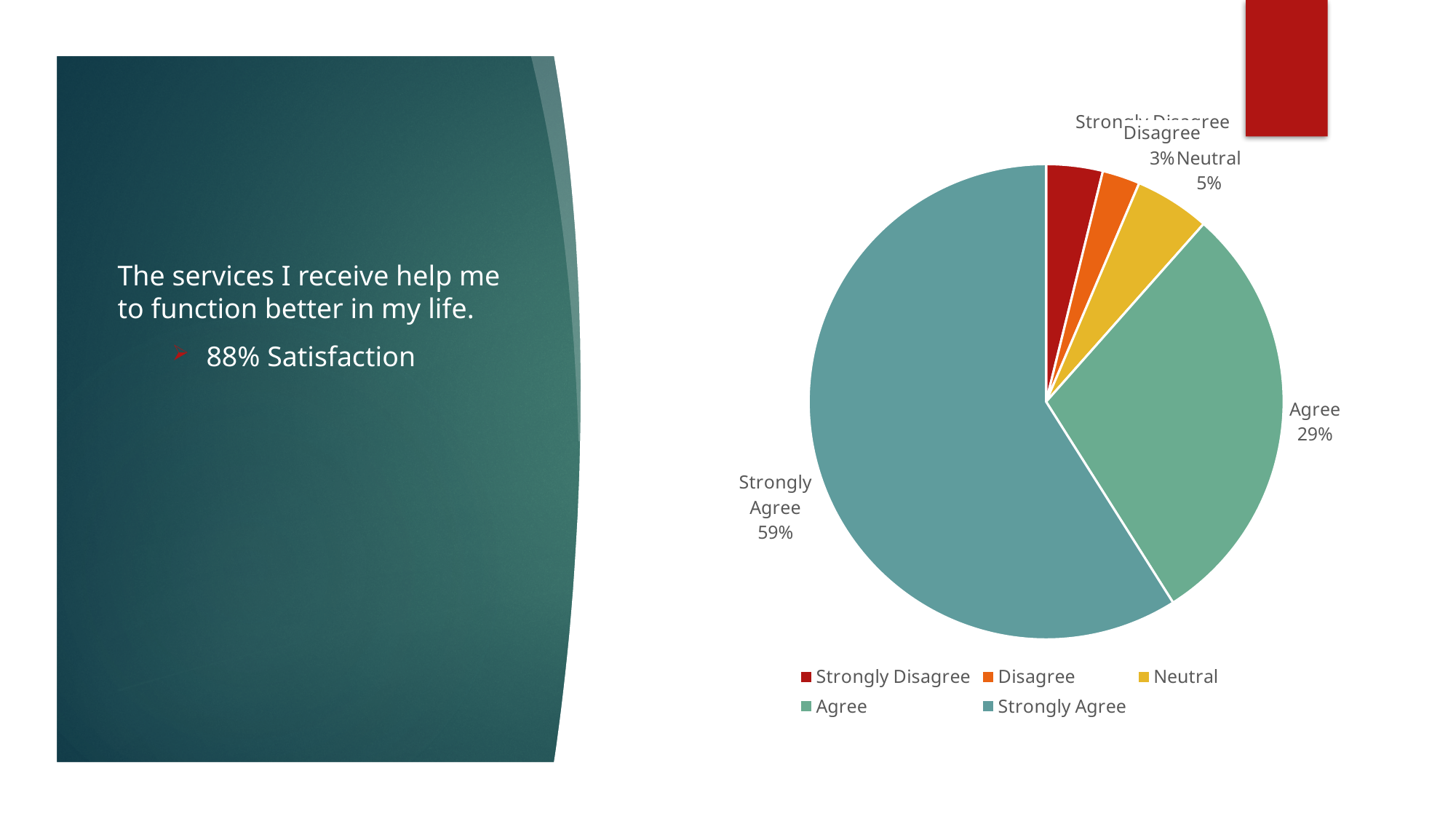
Which response category has the largest share of the pie? Strongly Agree What percentage of respondents answered Agree? 29% What is the combined share of Agree and Strongly Agree? 88% What percentage of respondents answered Disagree? 3% What percentage of respondents answered Strongly Agree? 59% What percentage of respondents answered Neutral? 5% What colour represents Neutral in the pie chart? yellow How many entries does the legend list? 5 Which is larger, the share for Agree or the share for Neutral? Agree What kind of chart is shown on the slide? pie chart How many response categories are shown in the pie chart? 5 What is the difference in percentage points between Strongly Agree and Agree? 30%